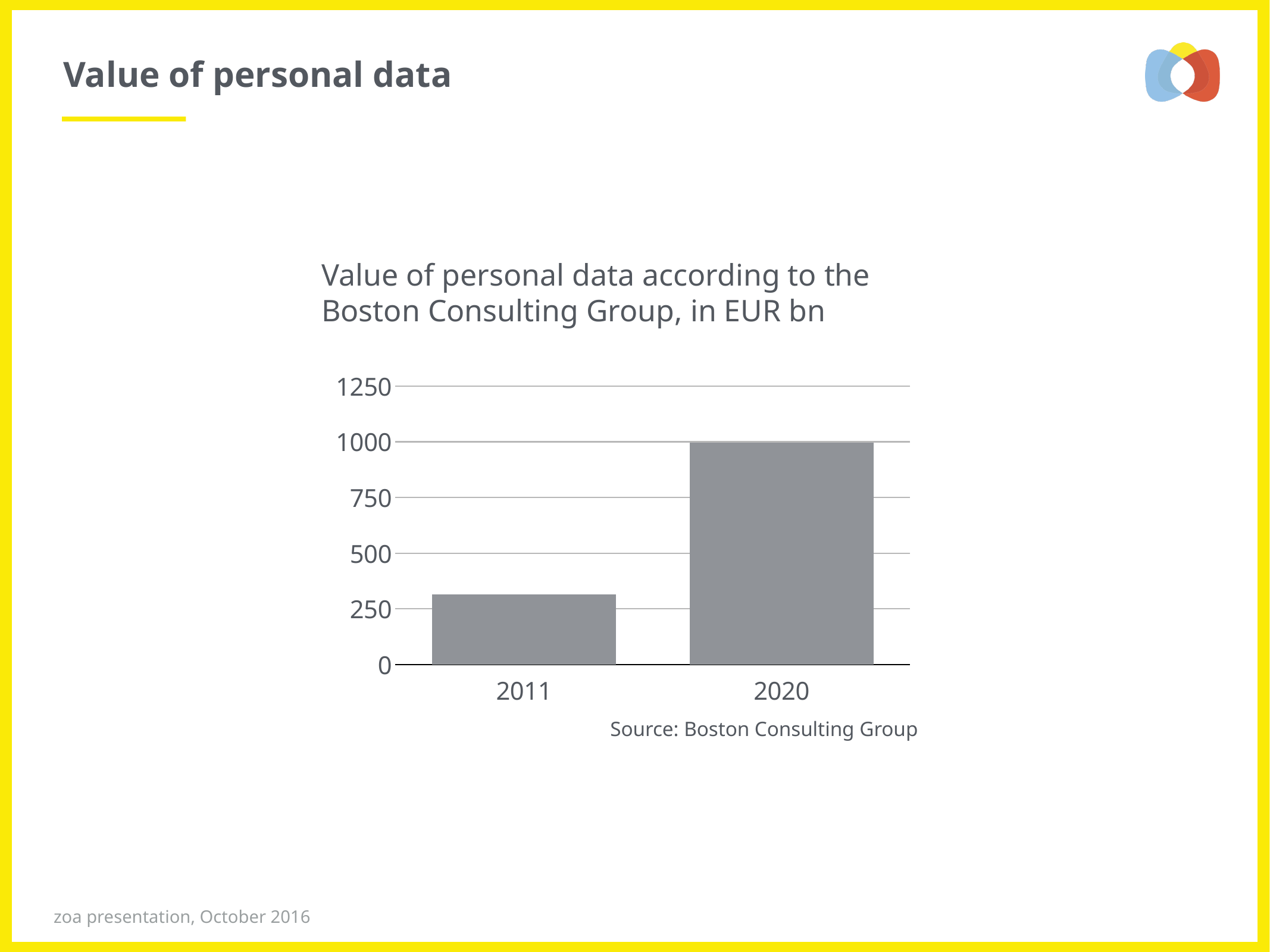
Is the value for 2011 greater or less than 500? less Which year has the lowest value in the chart? 2011 Is the value for 2020 greater or less than 750? greater Which is larger, the value for 2011 or the value for 2020? 2020 Which year has the highest value in the chart? 2020 How many categories are shown on the x axis of the chart? 2 What is the title of the chart? Value of personal data according to the Boston Consulting Group, in EUR bn What source is cited below the chart? Boston Consulting Group Is the value for 2011 greater or less than 250? greater What type of chart is shown on the slide? bar chart Do the values rise or fall from 2011 to 2020? rise